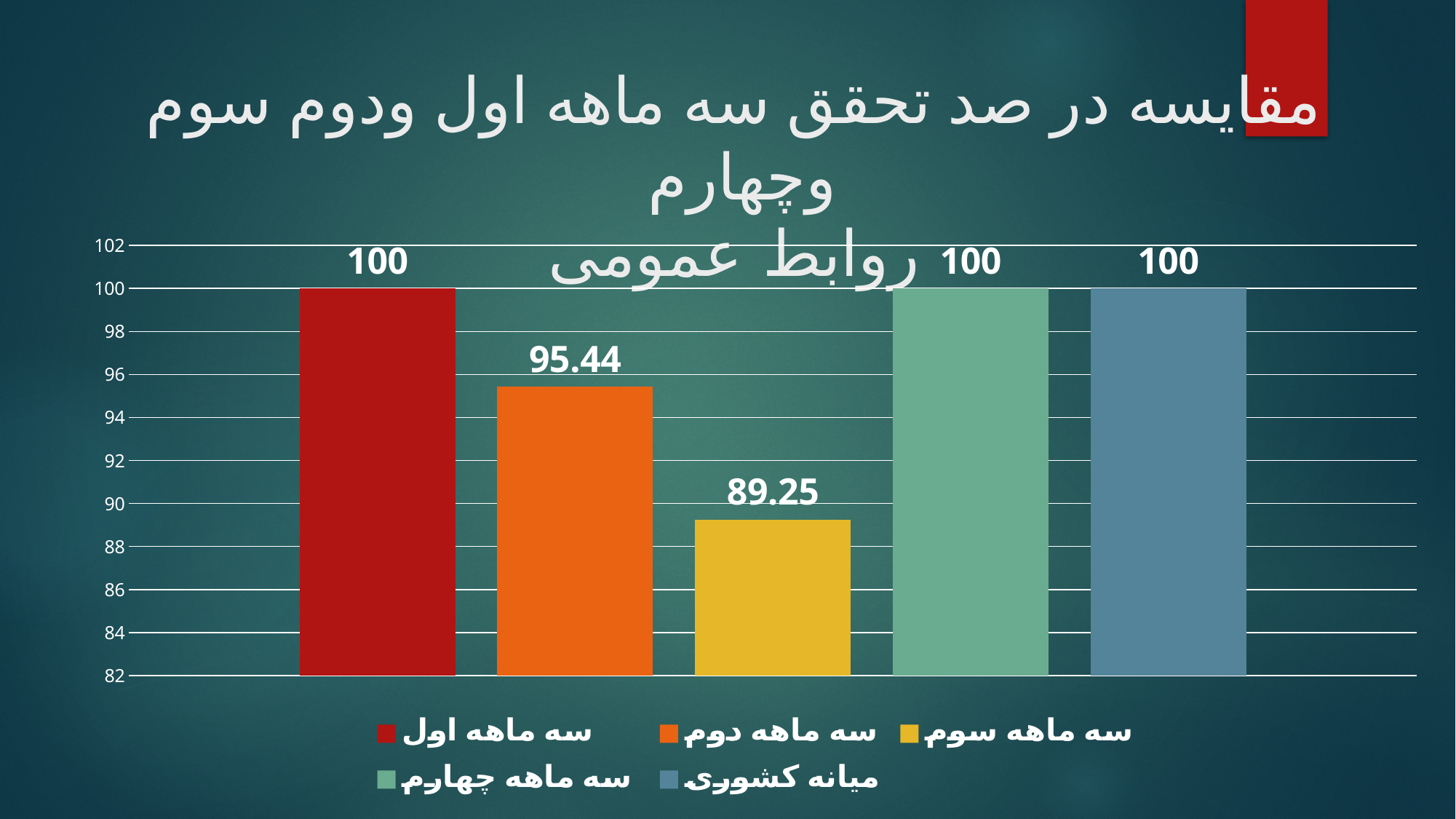
What is the difference between the values for سه ماهه دوم and سه ماهه سوم? 6.19 What is the value for میانه کشوری? 100 What is the title shown above the plot area of the chart? روابط عمومی What kind of chart is shown on the slide? bar chart Which series has the lowest value? سه ماهه سوم How many series does the legend list? 5 What is the value for سه ماهه دوم? 95.44 Is the value for سه ماهه سوم greater or less than 90? less What is the difference between the values for سه ماهه اول and سه ماهه دوم? 4.56 What is the value for سه ماهه سوم? 89.25 Which is larger, the value for سه ماهه دوم or the value for سه ماهه سوم? سه ماهه دوم What is the value for سه ماهه اول? 100